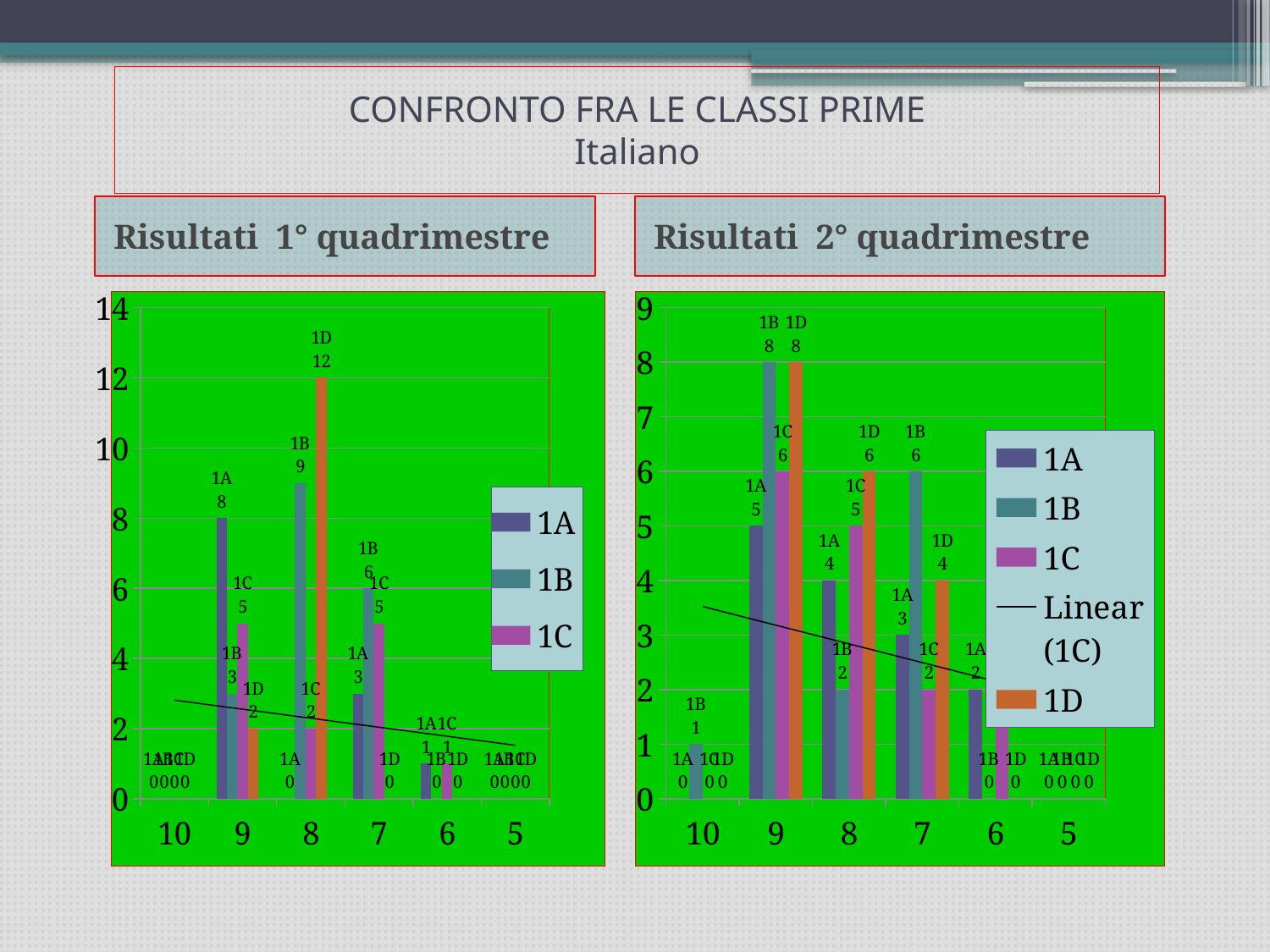
What kind of chart is the 'Risultati 1° quadrimestre' chart? Bar chart In the 'Risultati 1° quadrimestre' chart, which series and grade has the highest bar? 1D at grade 8 In the 'Risultati 2° quadrimestre' chart, which is larger at grade 9: the value for 1A or the value for 1C? 1C How many grade categories are shown on the x axis of the 'Risultati 2° quadrimestre' chart? 6 In the 'Risultati 1° quadrimestre' chart, what is the value for 1D at grade 8? 12 In the 'Risultati 2° quadrimestre' chart, what is the value for 1D at grade 8? 6 In the 'Risultati 1° quadrimestre' chart, what is the value for 1A at grade 9? 8 How many entries does the legend of the 'Risultati 2° quadrimestre' chart list? 5 In the 'Risultati 1° quadrimestre' chart, what is the value for 1C at grade 7? 5 In the 'Risultati 2° quadrimestre' chart, what is the difference between the 1D value at grade 9 and the 1D value at grade 7? 4 In the 'Risultati 2° quadrimestre' chart, what is the value for 1B at grade 9? 8 In the 'Risultati 1° quadrimestre' chart, what is the difference between the 1B value at grade 8 and the 1B value at grade 7? 3